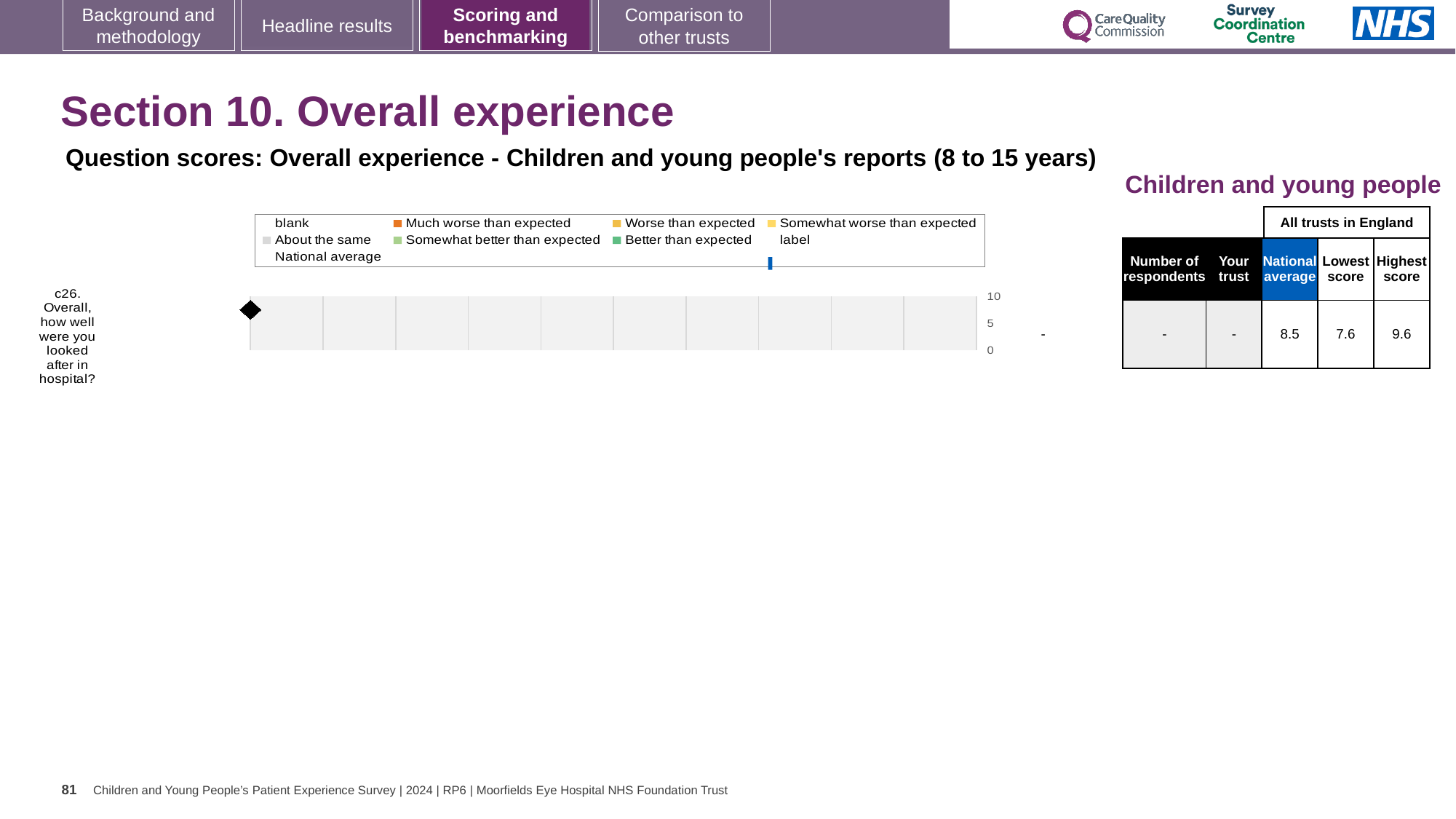
In the table, what is the National average score for c26? 8.5 What is the question label shown on the chart's category axis? c26. Overall, how well were you looked after in hospital? What is the highest value shown on the chart's vertical axis? 10 In the table, is the National average for c26 greater or less than 5? greater In the table, what is the difference between the Highest score and the Lowest score for c26? 2.0 How many survey questions are plotted on the chart? 1 In the table, what is shown for Your trust score for c26? - In the table, what is the Lowest score among all trusts in England for c26? 7.6 What kind of chart is used for the question scores? bar chart In the table, what is the Highest score among all trusts in England for c26? 9.6 In the table, which is larger for c26: the National average or the Lowest score? National average